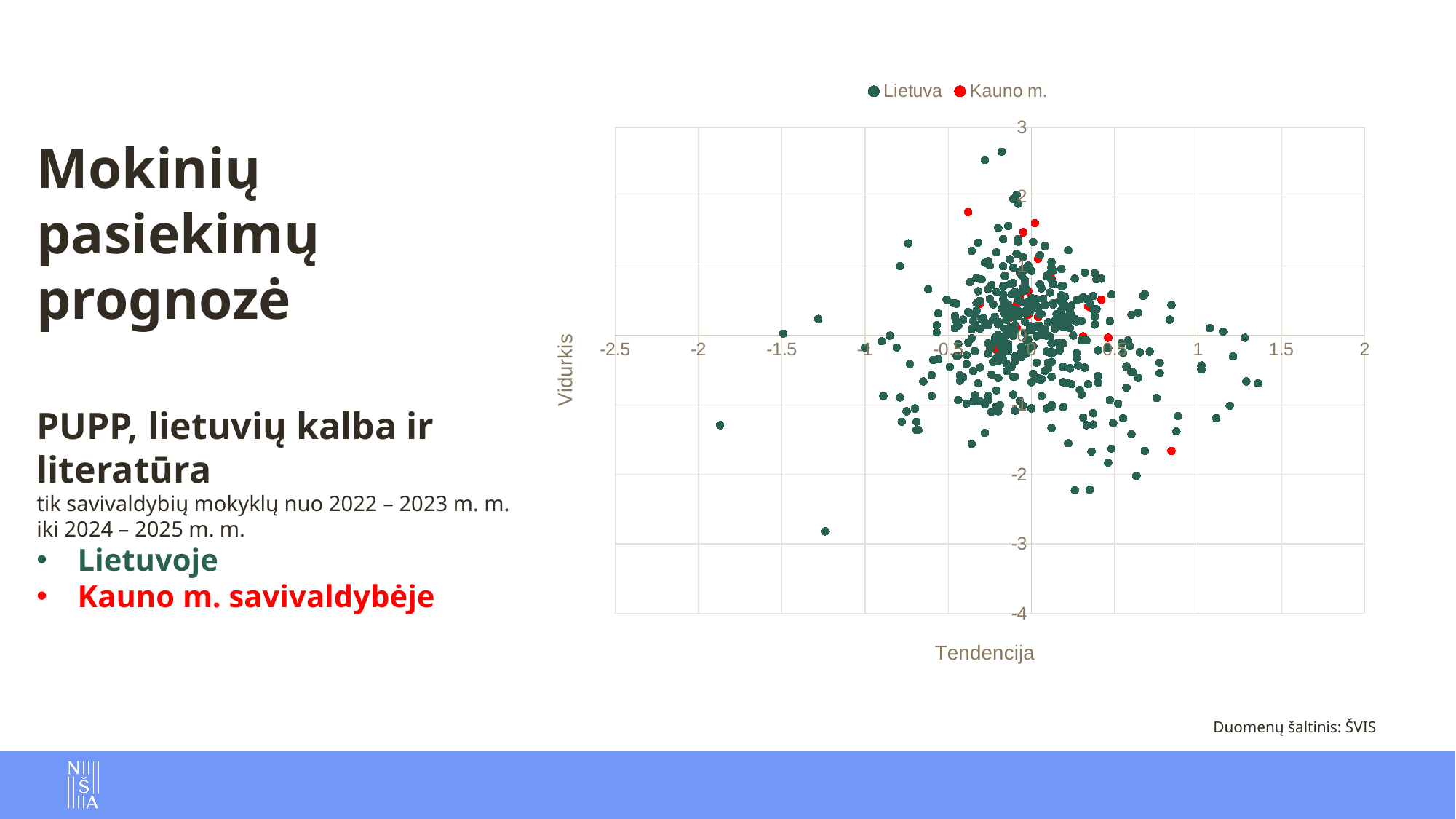
Is the Tendencija value of the leftmost point on the chart greater or less than -1.5? less What kind of chart is shown on the slide? scatter plot What is the label of the horizontal axis of the chart? Tendencija What colour are the points for the Kauno m. series? red How many series does the chart legend list? 2 Is the Vidurkis value of the lowest red (Kauno m.) point greater or less than -1? less What is the label of the vertical axis of the chart? Vidurkis What is the lowest value shown on the vertical axis of the chart? -4 Is the Vidurkis value of the lowest point on the chart greater or less than -2? less What are the two series named in the chart legend? Lietuva and Kauno m. What is the highest value shown on the horizontal axis of the chart? 2